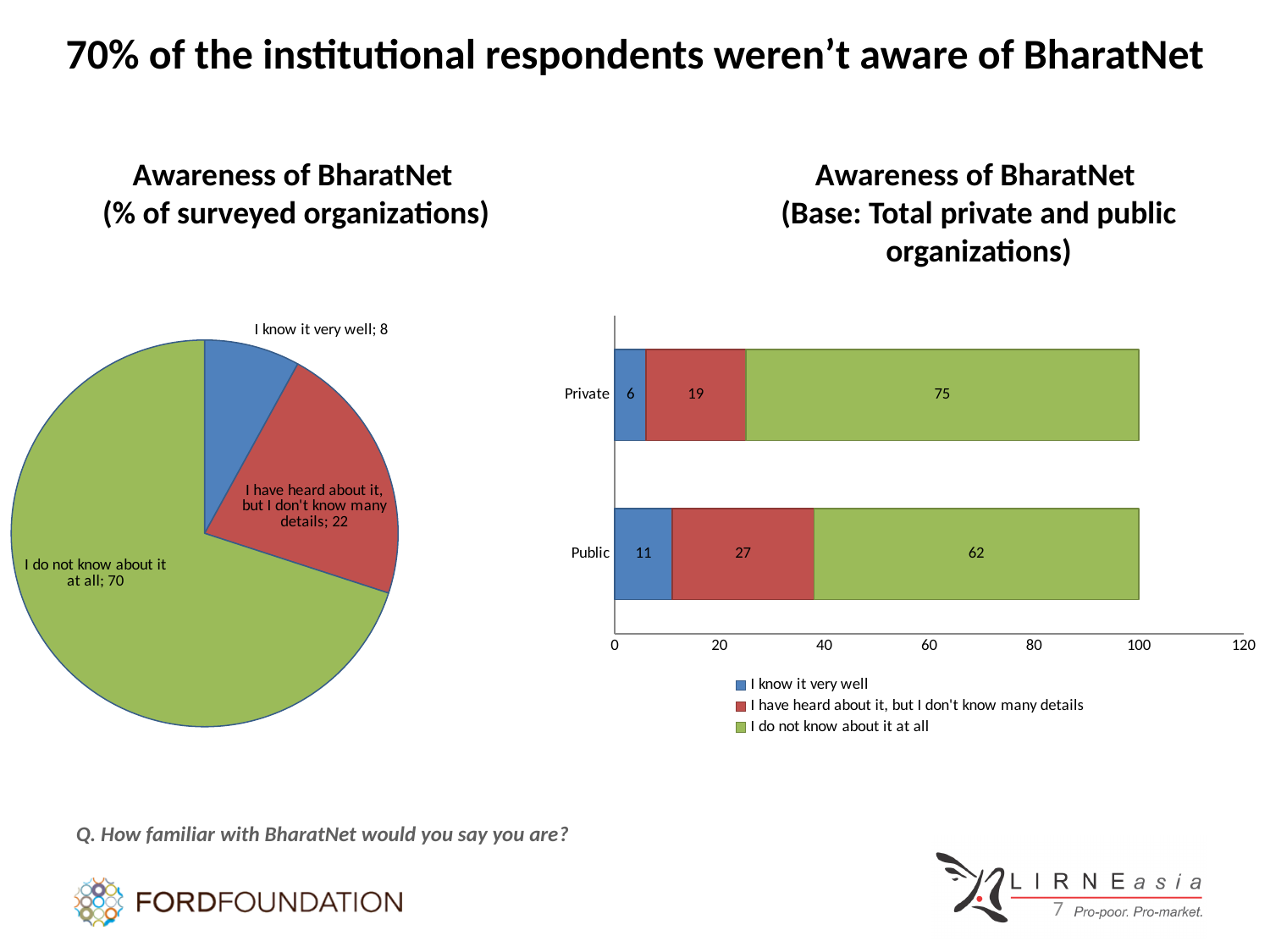
What kind of chart is the chart on the right of the slide? Stacked bar chart In the pie chart on the left, how many slices are there? 3 In the pie chart 'Awareness of BharatNet (% of surveyed organizations)', what is the value for 'I do not know about it at all'? 70 In the pie chart on the left, which category has the smallest slice? I know it very well In the bar chart on the right, what is the value for 'I know it very well' for Public? 11 In the bar chart on the right, which is larger: the 'I do not know about it at all' value for Private or for Public? Private In the bar chart on the right, what is the difference between the 'I have heard about it, but I don't know many details' values for Public and Private? 8 In the bar chart on the right, what is the total of the stacked bar for Public? 100 In the pie chart 'Awareness of BharatNet (% of surveyed organizations)', what is the value for 'I know it very well'? 8 In the bar chart 'Awareness of BharatNet (Base: Total private and public organizations)', what is the value for 'I do not know about it at all' for Private? 75 In the bar chart on the right, how many series does the legend list? 3 In the pie chart on the left, which category has the largest slice? I do not know about it at all